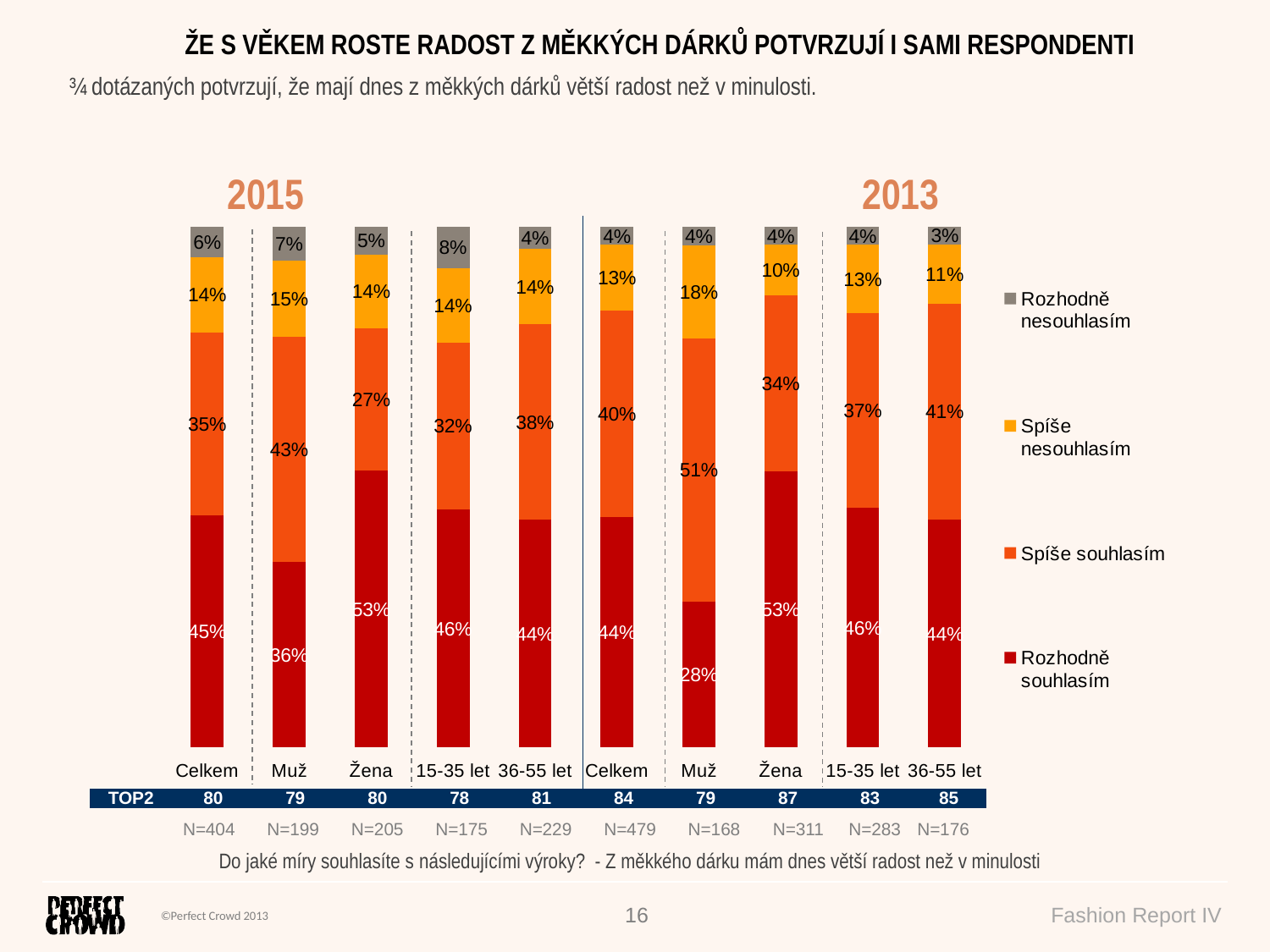
In the 2013 group, which category has the highest 'Spíše souhlasím' value? Muž What kind of chart is shown on the slide? Stacked bar chart What is the 'Spíše souhlasím' value for Muž in the 2013 group? 51% What is the 'Rozhodně souhlasím' value for Žena in the 2015 group? 53% Which is larger: the 'Spíše souhlasím' value for Celkem in 2015 or for Celkem in 2013? Celkem in 2013 What is the TOP2 value shown for Žena in the 2013 group? 87 What is the 'Rozhodně nesouhlasím' value for 15-35 let in the 2015 group? 8% What is the 'Spíše nesouhlasím' value for Muž in the 2013 group? 18% What is the difference between the 'Rozhodně souhlasím' values for Muž in 2015 and Muž in 2013? 8% How many categories are shown in the 2015 group? 5 How many series does the legend list? 4 In the 2015 group, which category has the lowest 'Rozhodně souhlasím' value? Muž